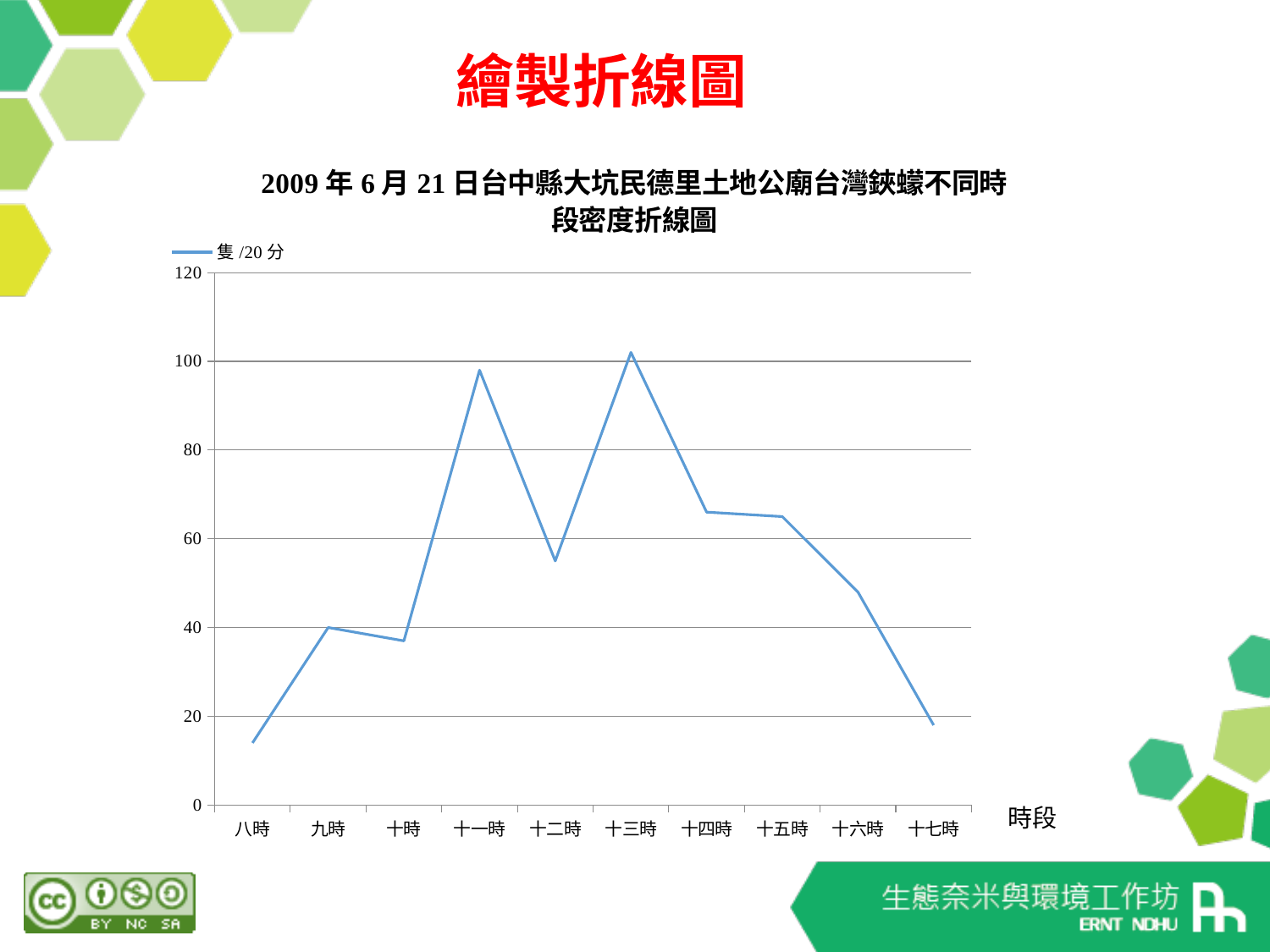
Is the value for 十三時 greater or less than 100? greater What is the label of the x axis? 時段 Is the value for 十二時 greater or less than 60? less Is the value for 十七時 greater or less than 20? less How many series does the legend list? 1 How many time periods are plotted along the x axis? 10 What is the legend entry for the plotted series? 隻/20分 At which time period is the density lowest? 八時 At which time period is the density highest? 十三時 What kind of chart is shown on the slide? line chart Do the values rise or fall from 十三時 to 十七時? fall Which has the higher value, 十一時 or 十二時? 十一時